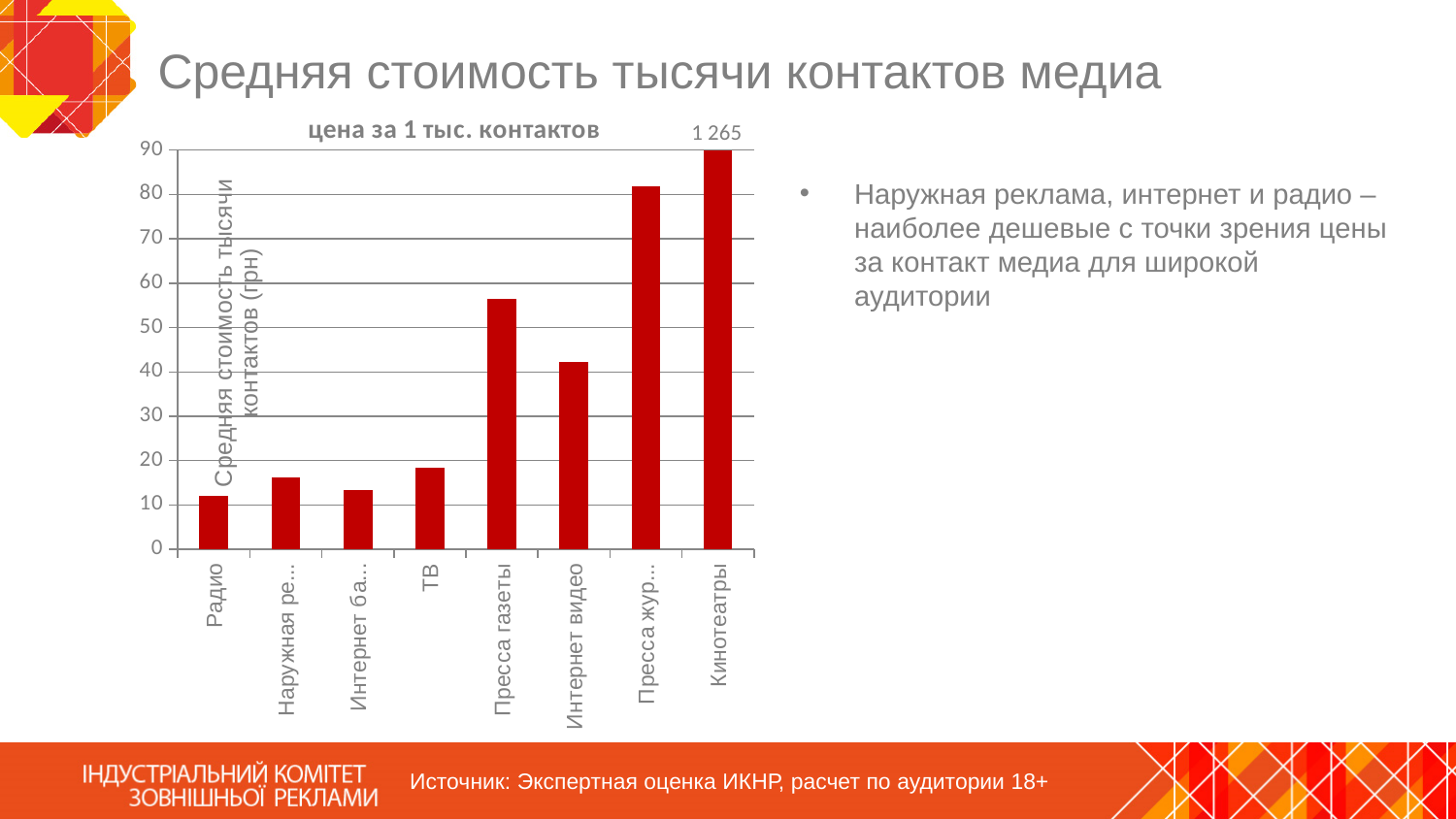
Is the value for Пресса жур... greater or less than 80? greater What is the value printed for Кинотеатры? 1 265 How many categories are shown on the x axis? 8 Which category has the highest value? Кинотеатры Which is larger, the value for ТВ or the value for Пресса газеты? Пресса газеты Which is larger, the value for Пресса газеты or the value for Интернет видео? Пресса газеты What kind of chart is shown? bar chart Is the value for Интернет видео greater or less than 50? less Is the value for Радио greater or less than 10? greater What is the title of the chart? цена за 1 тыс. контактов